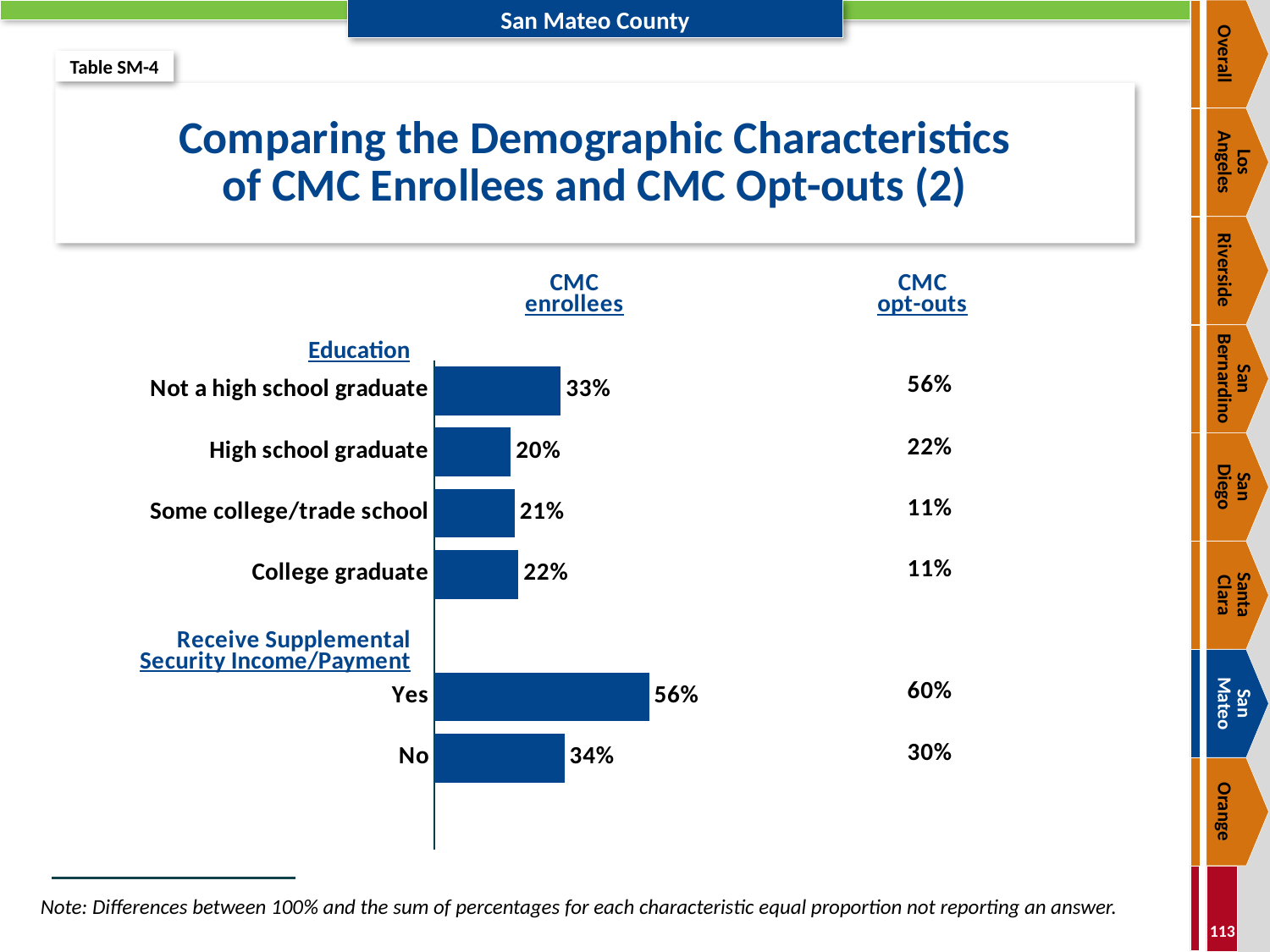
What is the difference in percentage points between CMC enrollees who receive Supplemental Security Income/Payment (Yes) and those who do not (No)? 22 percentage points What is the difference in percentage points between CMC opt-outs and CMC enrollees who are not a high school graduate? 23 percentage points What percentage of CMC enrollees are not a high school graduate? 33% How many bars are plotted in the chart? 6 What is the title of the chart on the slide? Comparing the Demographic Characteristics of CMC Enrollees and CMC Opt-outs (2) Among the education categories, which has the highest percentage of CMC enrollees? Not a high school graduate For college graduates, which group has the larger percentage: CMC enrollees or CMC opt-outs? CMC enrollees What percentage of CMC opt-outs are not a high school graduate? 56% What type of chart is shown on the slide? Bar chart What percentage of CMC opt-outs do not receive Supplemental Security Income/Payment (No)? 30% What percentage of CMC enrollees receive Supplemental Security Income/Payment (Yes)? 56% Among the education categories, which has the lowest percentage of CMC enrollees? High school graduate